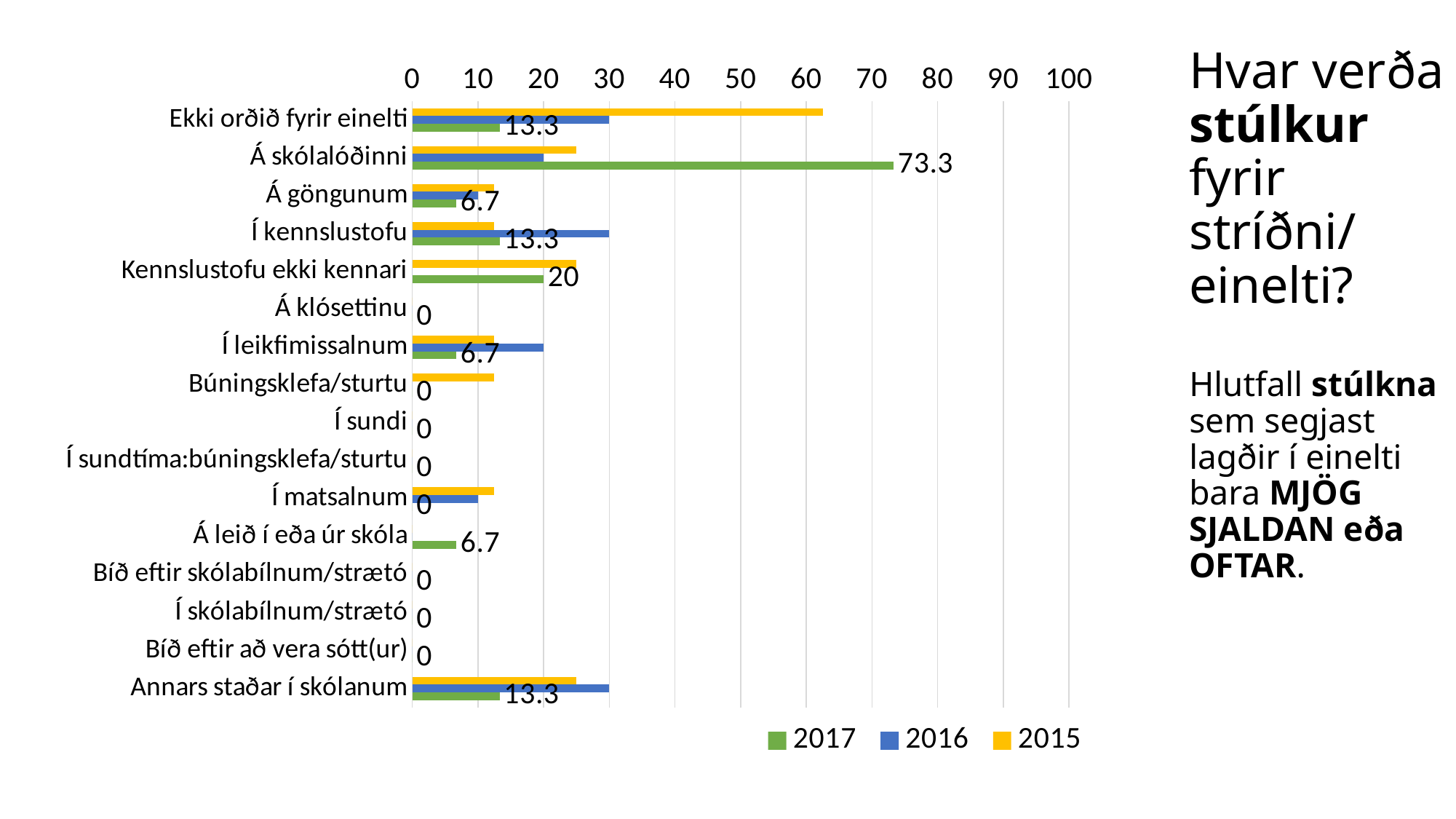
Which is larger for 2017: Kennslustofu ekki kennari or Í leikfimissalnum? Kennslustofu ekki kennari What is the 2017 value for Á skólalóðinni? 73.3 How many series does the legend list? 3 What is the 2017 value for Annars staðar í skólanum? 13.3 Which category has the highest 2017 value? Á skólalóðinni Is the 2015 value for Ekki orðið fyrir einelti greater or less than 50? greater What is the difference between the 2017 values for Á skólalóðinni and Ekki orðið fyrir einelti? 60 What is the 2017 value for Á leið í eða úr skóla? 6.7 What kind of chart is shown on the slide? Bar chart What is the 2017 value for Kennslustofu ekki kennari? 20 How many categories are shown on the chart? 16 Is the 2016 value for Á skólalóðinni greater or less than 30? less